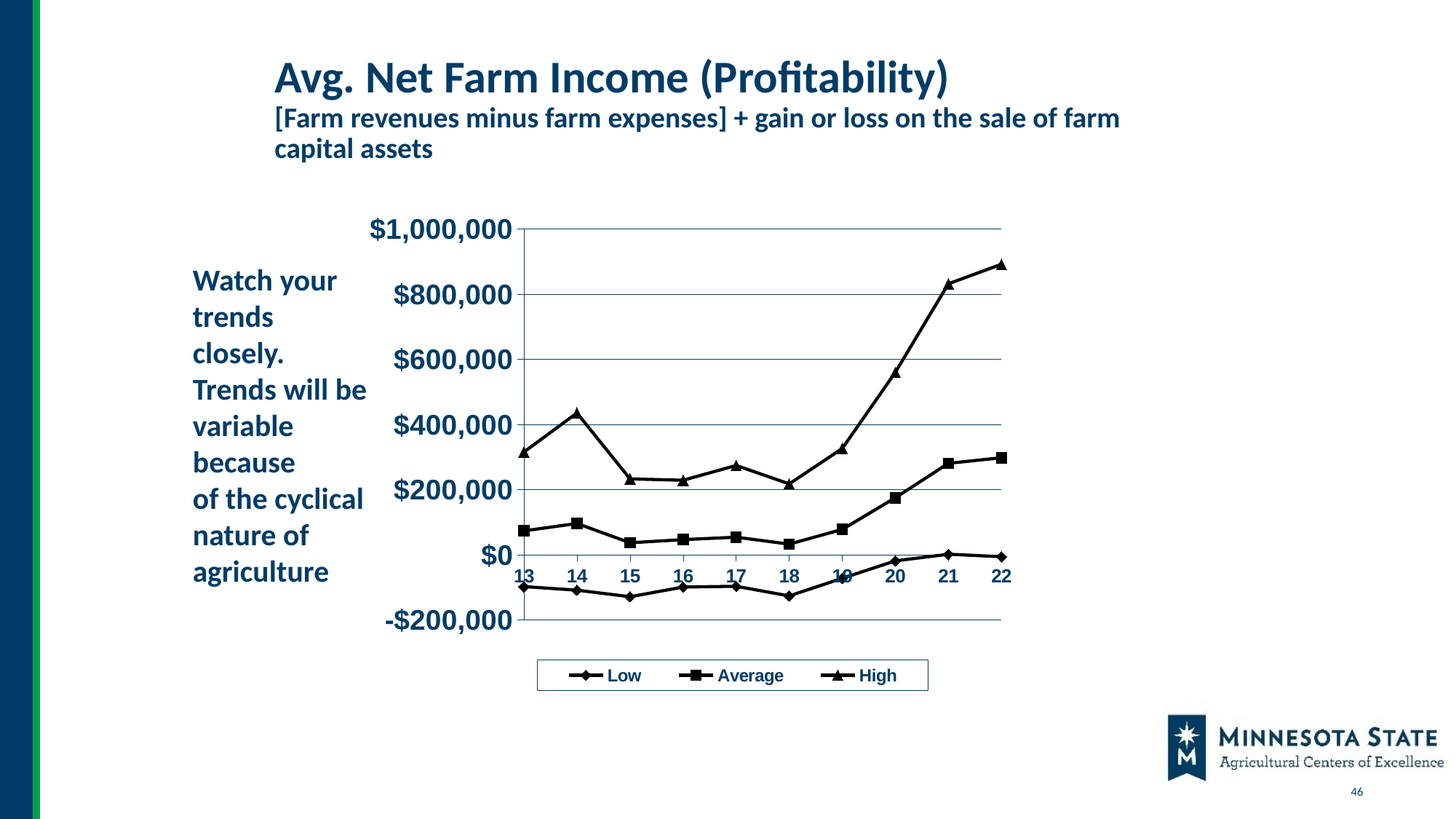
Is the value for the Low series in year 15 greater or less than $0? less How many series does the legend list? 3 Which series are listed in the legend? Low, Average, High Is the value for the High series in year 22 greater or less than $800,000? greater Does the High series rise or fall from year 18 to year 22? rise How many years are plotted along the x axis? 10 In which year does the High series reach its highest value? 22 Is the value for the High series in year 13 greater or less than $400,000? less Which is larger for the High series: the value in year 14 or the value in year 15? year 14 What kind of chart is shown on the slide? line chart What is the title of the chart's slide? Avg. Net Farm Income (Profitability)